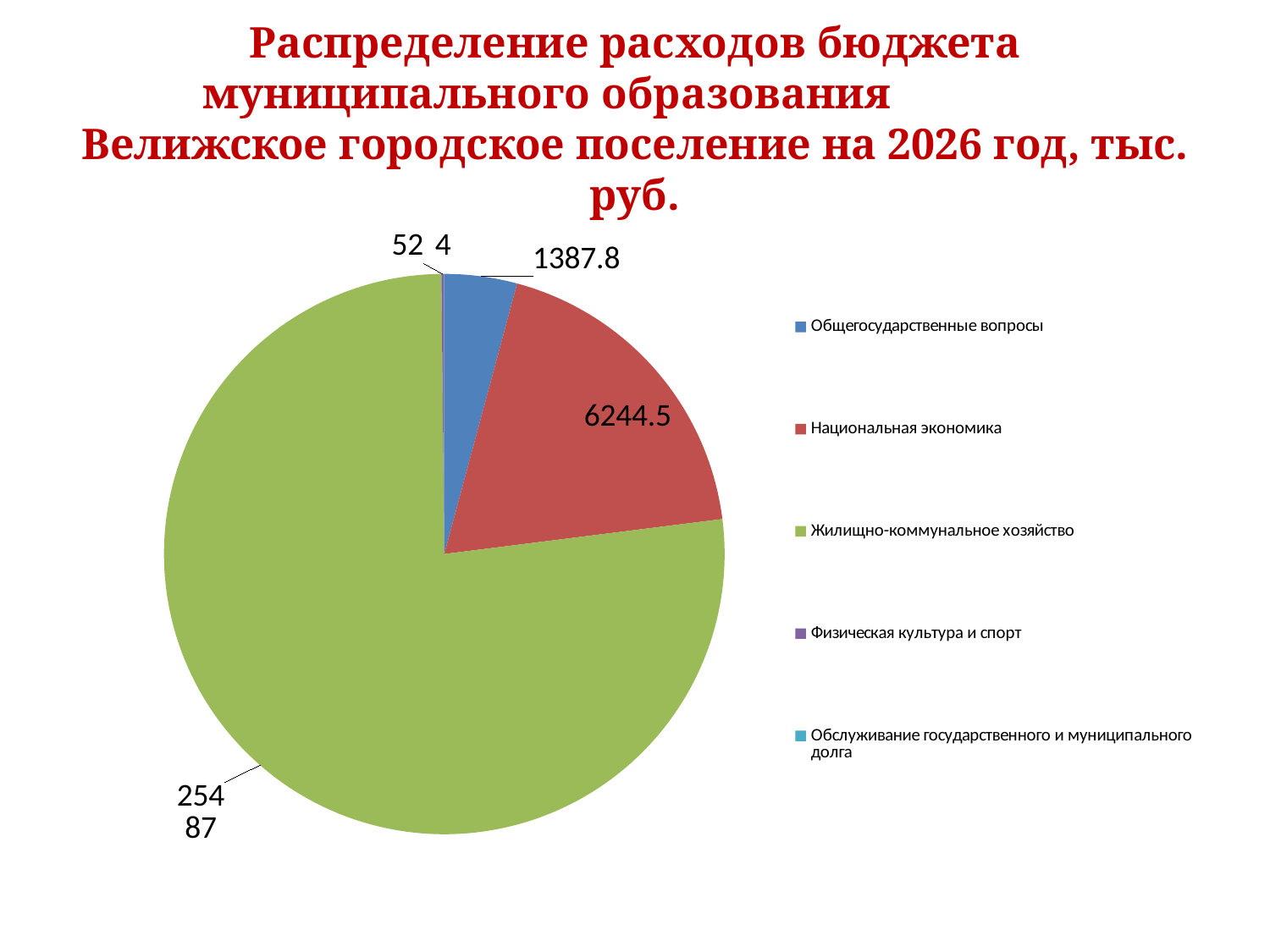
What kind of chart is shown on the slide? pie chart What is the value for Общегосударственные вопросы? 1387.8 What is the value for Физическая культура и спорт? 52 What is the value for Национальная экономика? 6244.5 What colour is the slice for Национальная экономика? red Which category has the smallest slice of the pie? Обслуживание государственного и муниципального долга What is the difference between the values for Национальная экономика and Общегосударственные вопросы? 4856.7 Which is larger, the value for Национальная экономика or the value for Общегосударственные вопросы? Национальная экономика Which category has the largest slice of the pie? Жилищно-коммунальное хозяйство What is the value for Обслуживание государственного и муниципального долга? 4 What is the difference between the values for Физическая культура и спорт and Обслуживание государственного и муниципального долга? 48 How many categories does the legend list? 5